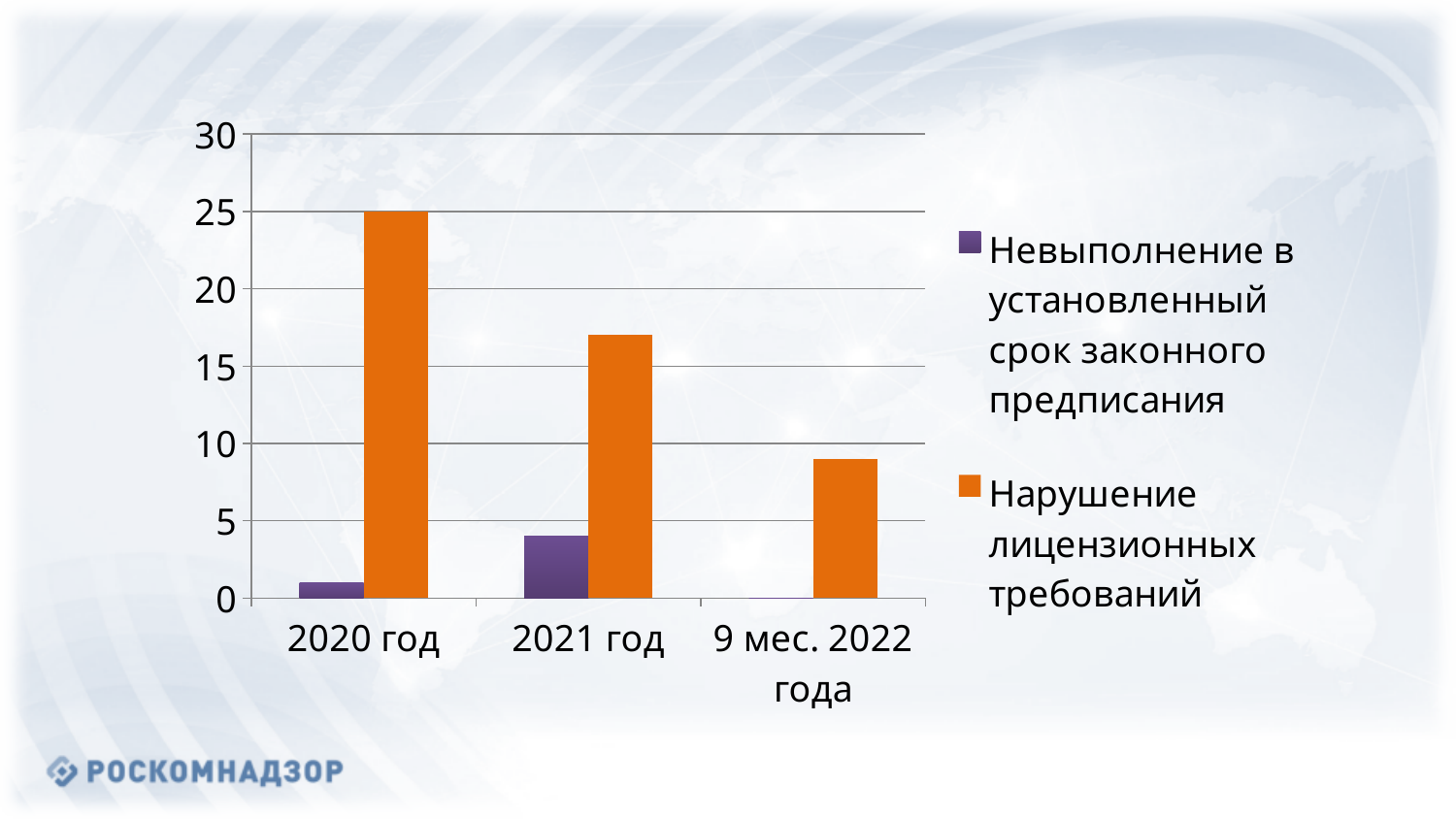
What kind of chart is shown on the slide? bar chart Do the values for Нарушение лицензионных требований rise or fall from 2020 год to 9 мес. 2022 года? fall Is the value for Невыполнение в установленный срок законного предписания in 2021 год greater or less than 5? less What colour are the bars for Нарушение лицензионных требований? orange Which category has the highest value for Невыполнение в установленный срок законного предписания? 2021 год Is the value for Нарушение лицензионных требований in 2021 год greater or less than 15? greater How many categories are shown on the x axis? 3 How many series does the legend list? 2 Which category has the highest value for Нарушение лицензионных требований? 2020 год Which is larger in 2020 год: Нарушение лицензионных требований or Невыполнение в установленный срок законного предписания? Нарушение лицензионных требований Is the value for Нарушение лицензионных требований in 9 мес. 2022 года greater or less than 10? less Which category has the lowest value for Нарушение лицензионных требований? 9 мес. 2022 года